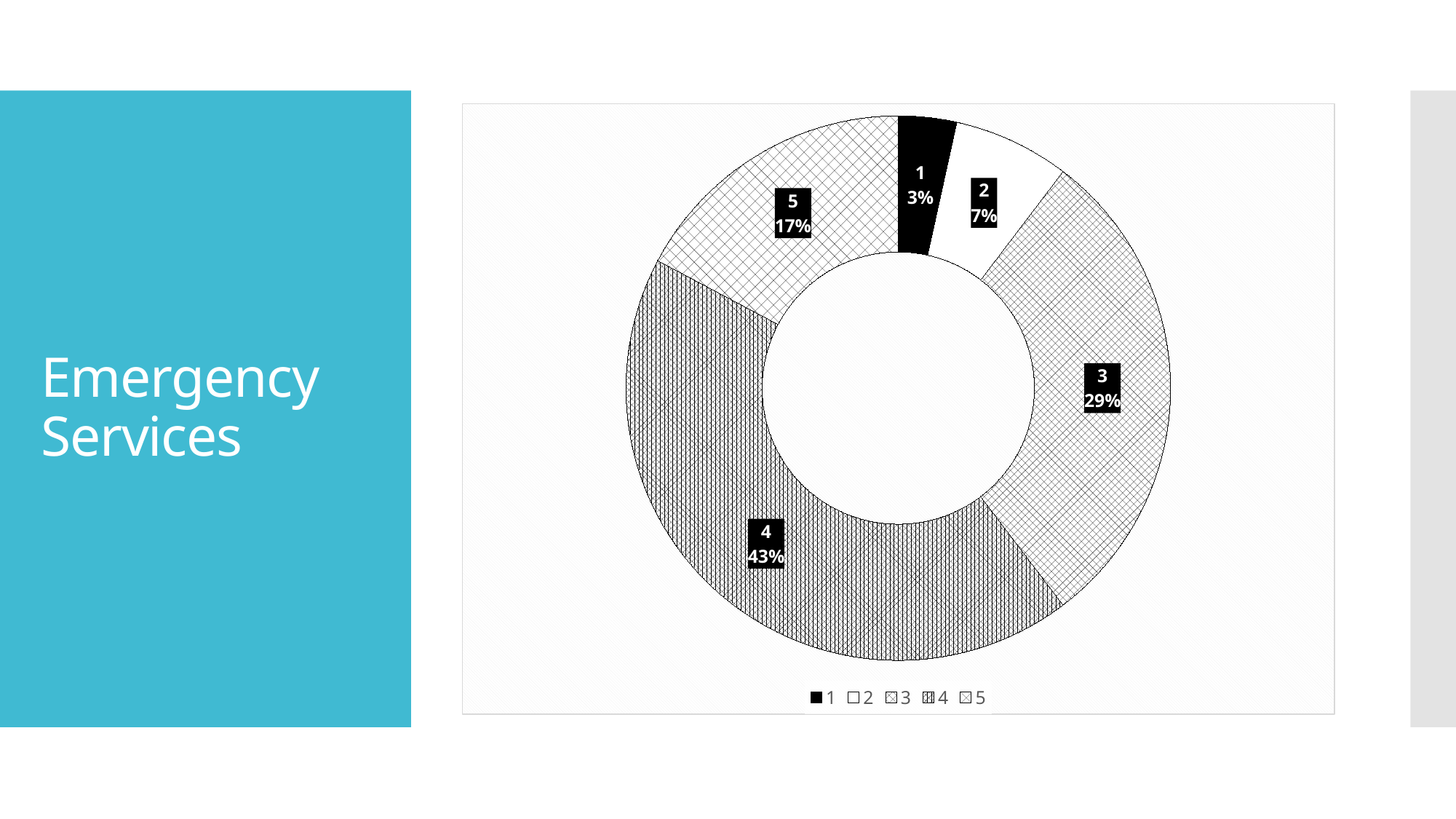
How many categories does the chart show? 5 Which category has the smallest share of the chart? 1 Which category has the largest share of the chart? 4 What is the difference in percentage points between category 4 and category 3? 14 What percentage is shown for category 4? 43% What percentage is shown for category 5? 17% What percentage is shown for category 3? 29% What percentage is shown for category 1? 3% What percentage is shown for category 2? 7% What is the title of the slide containing the chart? Emergency Services What kind of chart is shown on the slide? Doughnut (pie) chart Which has a larger share, category 3 or category 5? 3